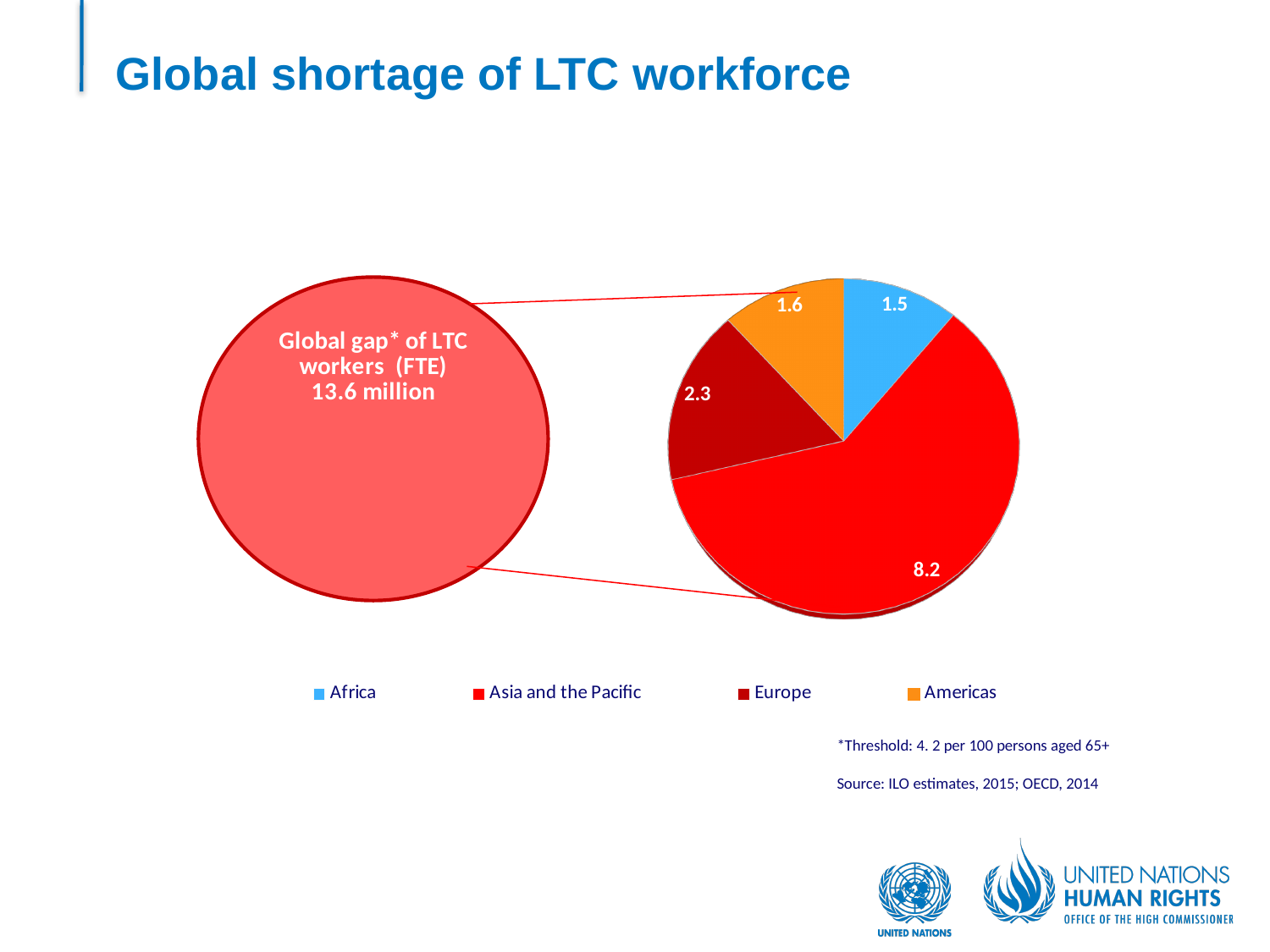
What type of chart is shown on the slide? Pie chart Which region has the largest slice of the pie chart? Asia and the Pacific Which region has the smallest slice of the pie chart? Africa Which is larger, the value for Europe or the value for the Americas? Europe How many regions are shown in the pie chart? 4 What is the value shown for Asia and the Pacific in the pie chart? 8.2 What is the value shown for Africa in the pie chart? 1.5 What is the difference between the values for Asia and the Pacific and Europe? 5.9 What is the total global gap of LTC workers (FTE) shown on the slide? 13.6 million What is the value shown for Europe in the pie chart? 2.3 What is the value shown for the Americas in the pie chart? 1.6 What colour represents Africa in the pie chart? Light blue